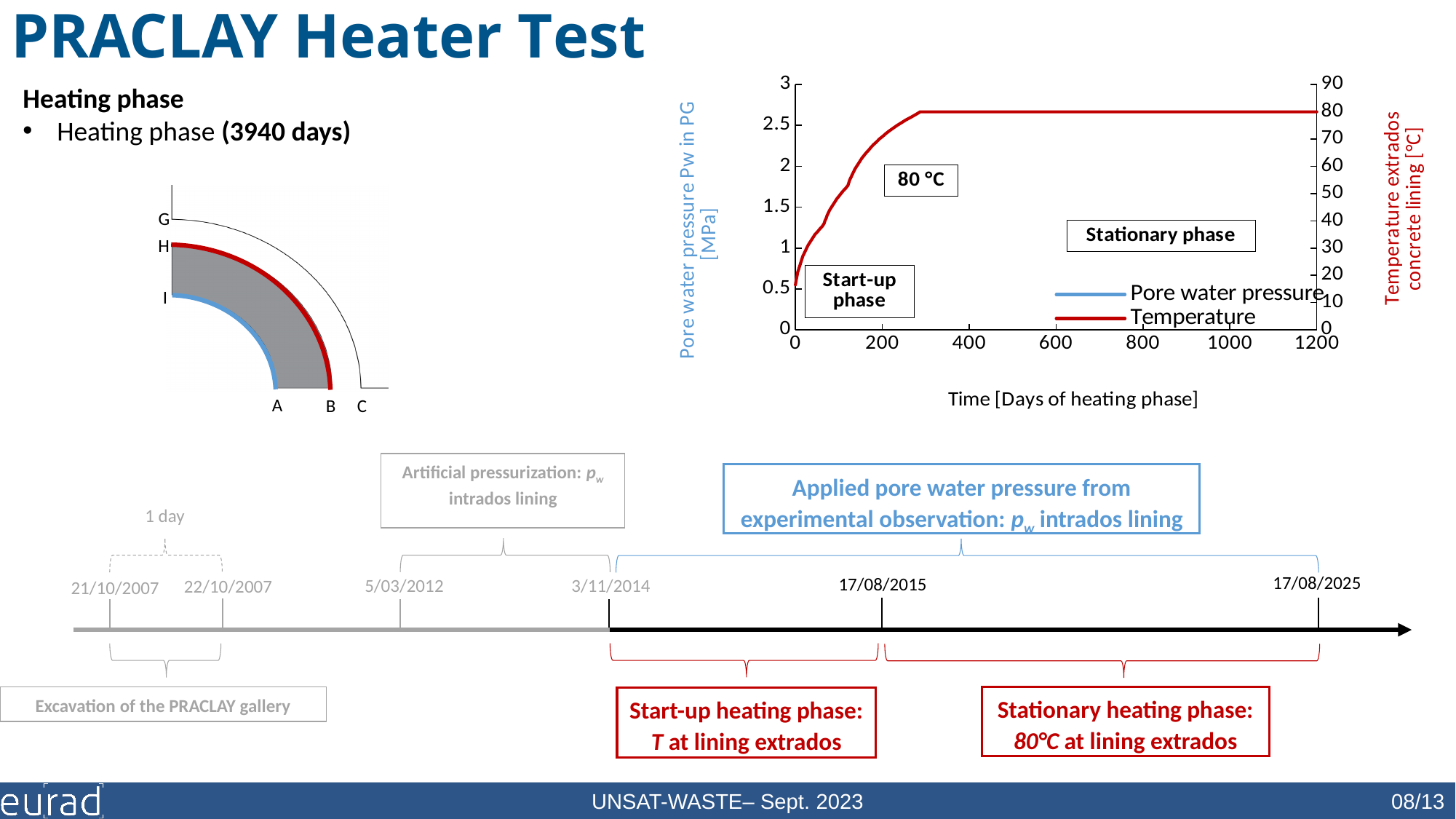
What temperature does the chart label show for the stationary phase? 80 °C Does the temperature rise or fall along the x axis during the start-up phase? rise Is the temperature at day 0 greater or less than 30 °C? less What is the title of the chart's x axis? Time [Days of heating phase] Is the temperature at day 1000 greater or less than 90 °C? less After about day 300, does the temperature keep rising, fall, or stay flat? stay flat What are the two series listed in the chart legend? Pore water pressure and Temperature Is the temperature at day 100 greater or less than 40 °C? greater Is the temperature higher at day 200 or at day 800? day 800 What type of chart is shown on the slide? line chart How many series does the chart legend list? 2